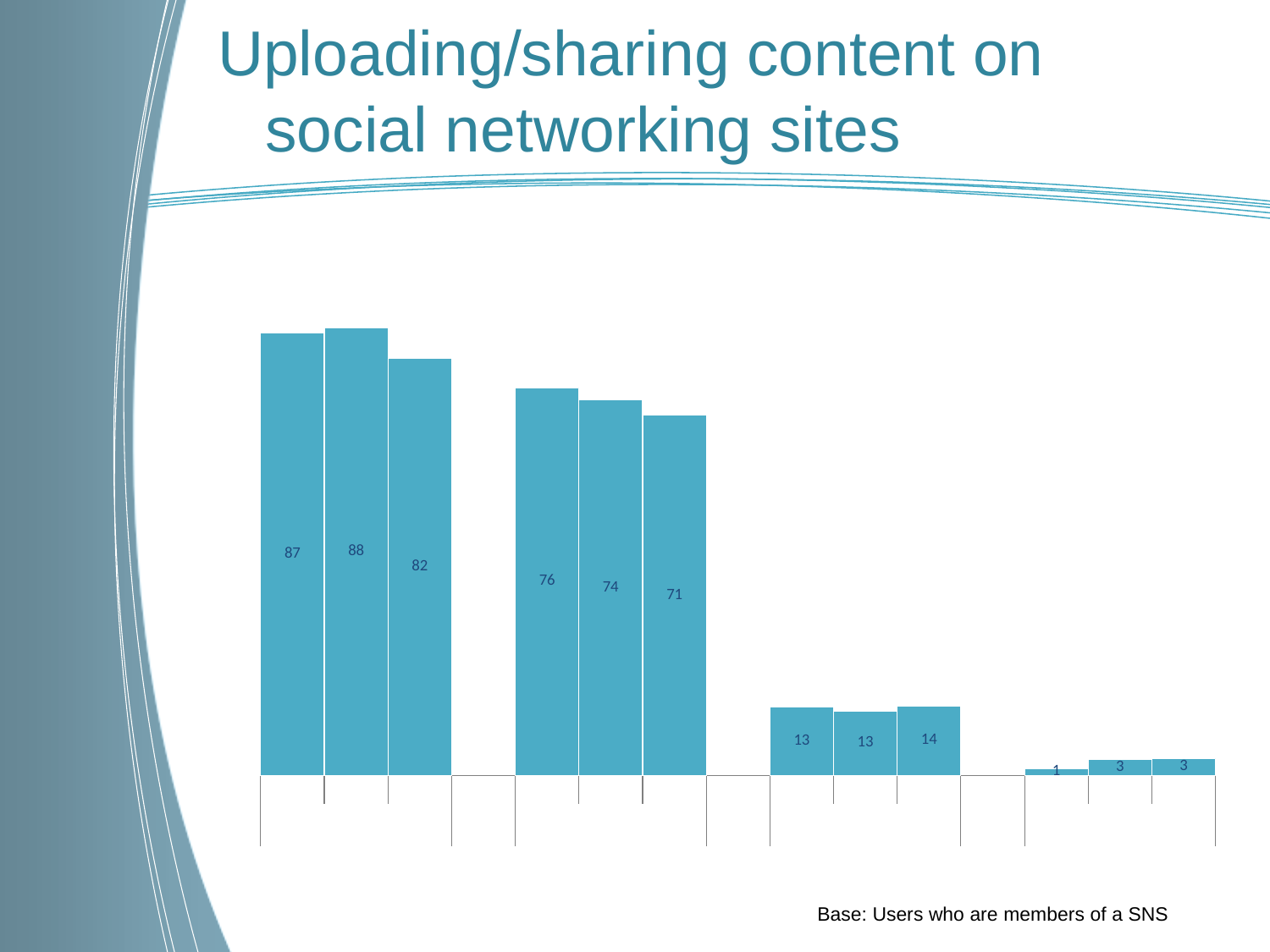
What kind of chart is shown on the slide? bar chart What is the value of the first (leftmost) bar in the first group? 87 What is the value of the third bar in the third group? 14 What is the value of the tallest bar in the chart? 88 What is the title of the slide containing the chart? Uploading/sharing content on social networking sites Do the bar values generally rise or fall moving from the left group to the right group? fall How many groups of bars does the chart contain? 4 What is the value of the shortest bar in the chart? 1 What is the difference between the second bar (88) and the third bar (82) in the first group? 6 How many bars are plotted in the chart? 12 Which is larger: the first bar of the second group (76) or the first bar of the third group (13)? 76 What is the value of the third bar in the second group? 71